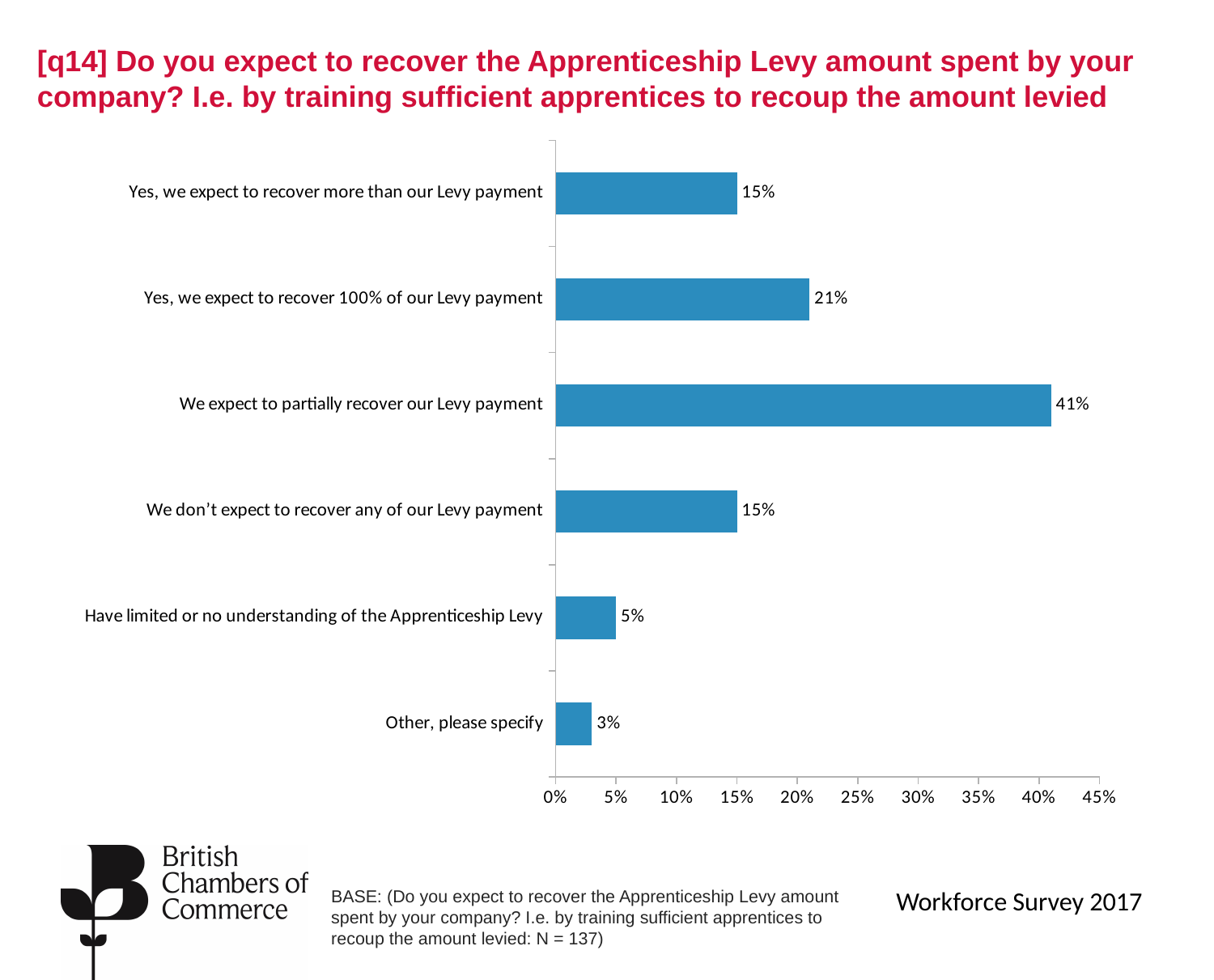
Which is larger: the percentage for 'Yes, we expect to recover 100% of our Levy payment' or for 'Yes, we expect to recover more than our Levy payment'? Yes, we expect to recover 100% of our Levy payment What percentage of respondents expect to recover 100% of their Levy payment? 21% Which response category has the highest percentage? We expect to partially recover our Levy payment What percentage of respondents expect to partially recover their Levy payment? 41% What is the difference in percentage points between 'We expect to partially recover our Levy payment' and 'Yes, we expect to recover 100% of our Levy payment'? 20 percentage points What percentage of respondents chose 'Other, please specify'? 3% Which response category has the lowest percentage? Other, please specify What percentage of respondents have limited or no understanding of the Apprenticeship Levy? 5% Is the value for 'We expect to partially recover our Levy payment' greater or less than 40%? greater How many response categories are shown in the chart? 6 What type of chart is shown on the slide? Bar chart What is the base size (N) stated for this question? N = 137